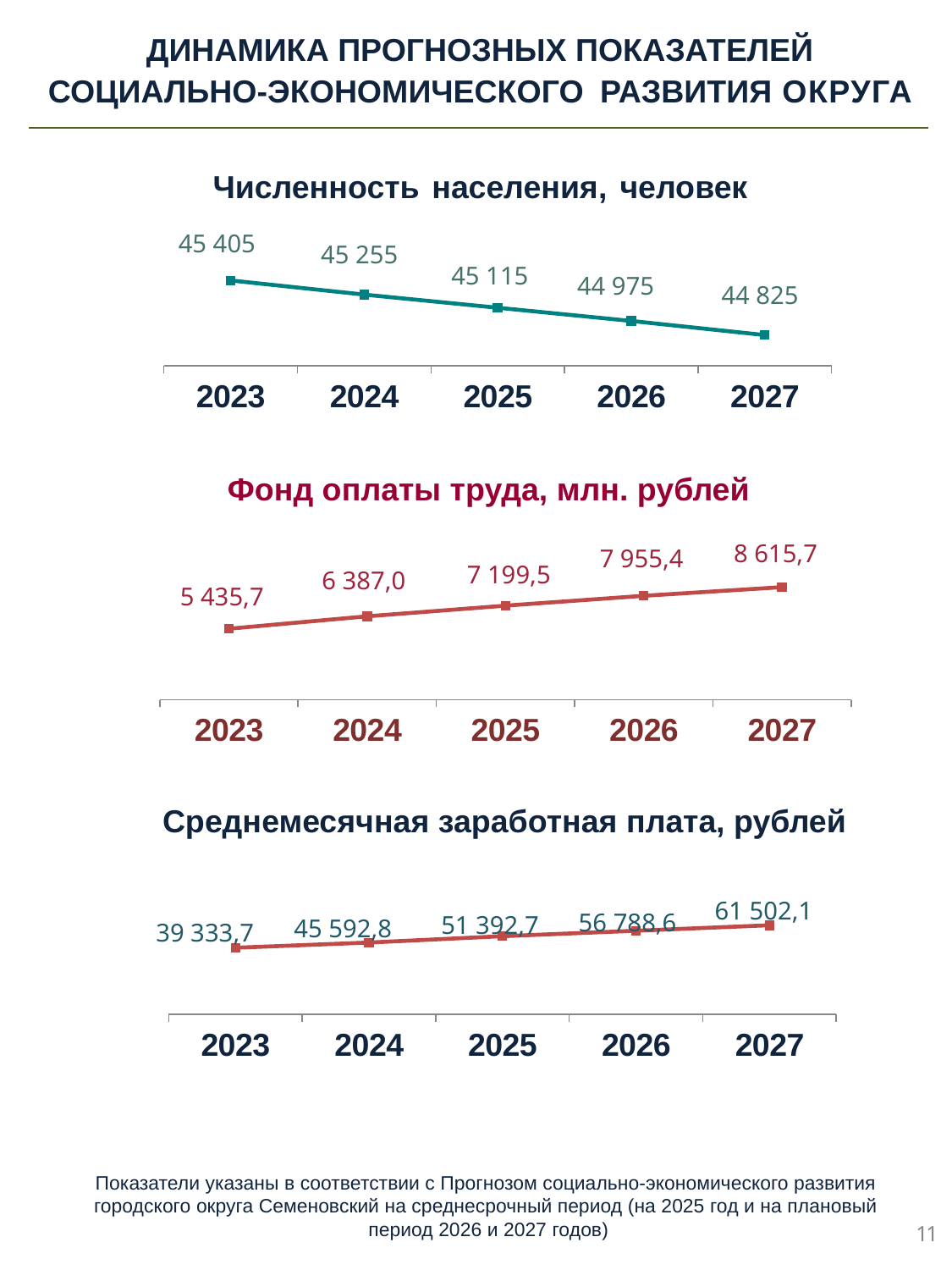
In the chart 'Среднемесячная заработная плата, рублей', what is the value for 2023? 39 333,7 In the chart 'Фонд оплаты труда, млн. рублей', what is the value for 2026? 7 955,4 In the chart 'Численность населения, человек', do the values rise or fall from 2023 to 2027? fall In the chart 'Среднемесячная заработная плата, рублей', do the values rise or fall from 2023 to 2027? rise In the chart 'Численность населения, человек', what is the difference between the 2023 and 2027 values? 580 In the chart 'Фонд оплаты труда, млн. рублей', by how much does the 2027 value exceed the 2023 value? 3 180,0 In the chart 'Численность населения, человек', which year has the lowest value? 2027 What type of chart is 'Численность населения, человек'? line chart In the chart 'Фонд оплаты труда, млн. рублей', which year has the highest value? 2027 How many years are plotted in the chart 'Фонд оплаты труда, млн. рублей'? 5 In the chart 'Численность населения, человек', what is the value for 2025? 45 115 In the chart 'Среднемесячная заработная плата, рублей', is the value for 2026 larger or smaller than the value for 2025? larger